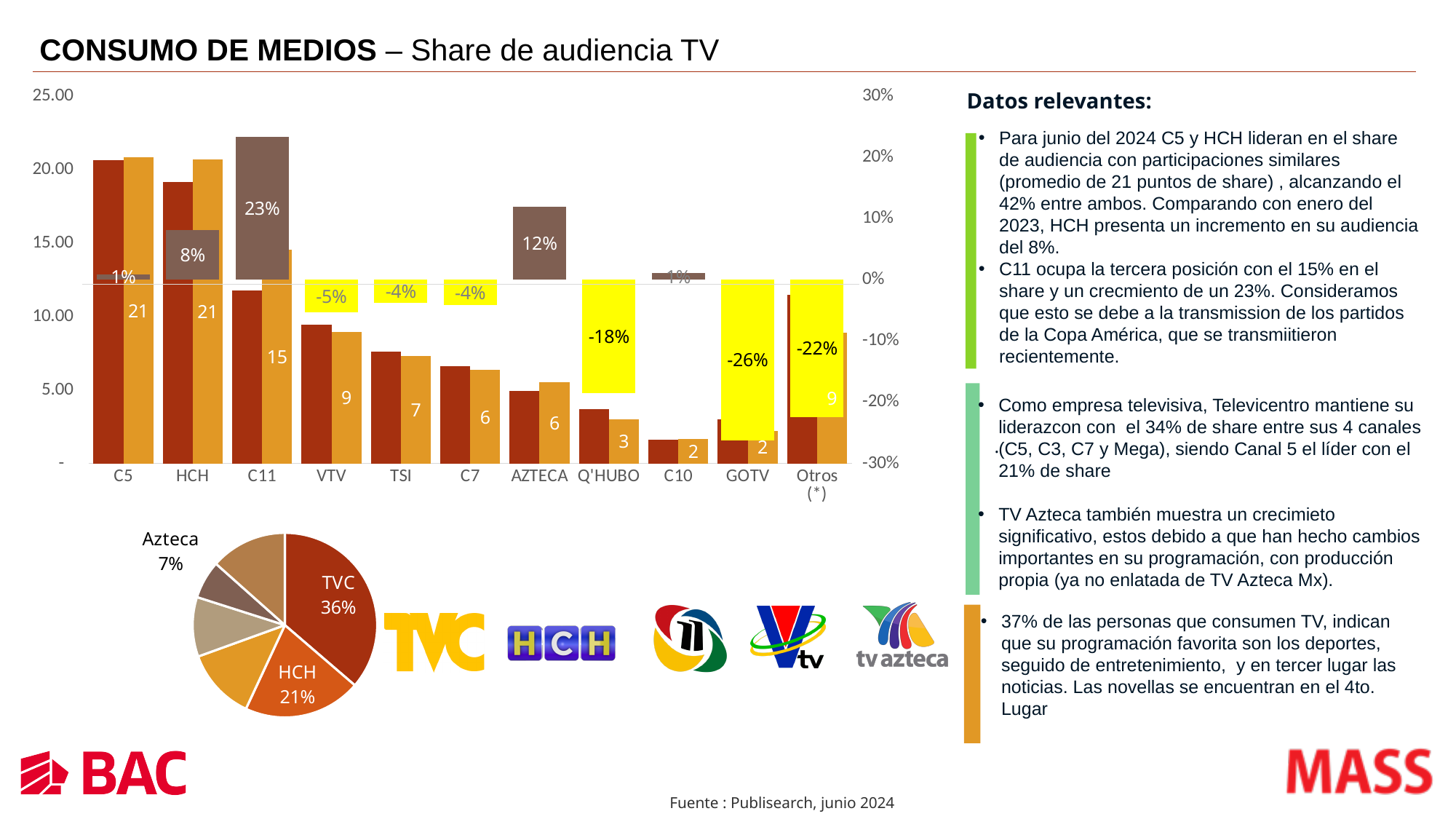
In the top bar chart, what is the difference between the labelled values for C5 and VTV? 12 In the top bar chart, what growth percentage is shown for C11? 23% What kind of chart is the top chart on the slide? bar chart In the top bar chart, which category has the highest growth percentage? C11 In the bottom-left pie chart, what share does TVC have? 36% How many categories are shown on the x axis of the top bar chart? 11 In the top bar chart, which has the larger labelled value, TSI or C7? TSI In the top bar chart, what growth percentage is shown for GOTV? -26% In the bottom-left pie chart, what is the difference between the shares of TVC and Azteca? 29% What kind of chart is the bottom-left chart on the slide? pie chart In the top bar chart, what value is labelled on the bar for C11? 15 In the top bar chart, which category has the lowest growth percentage? GOTV